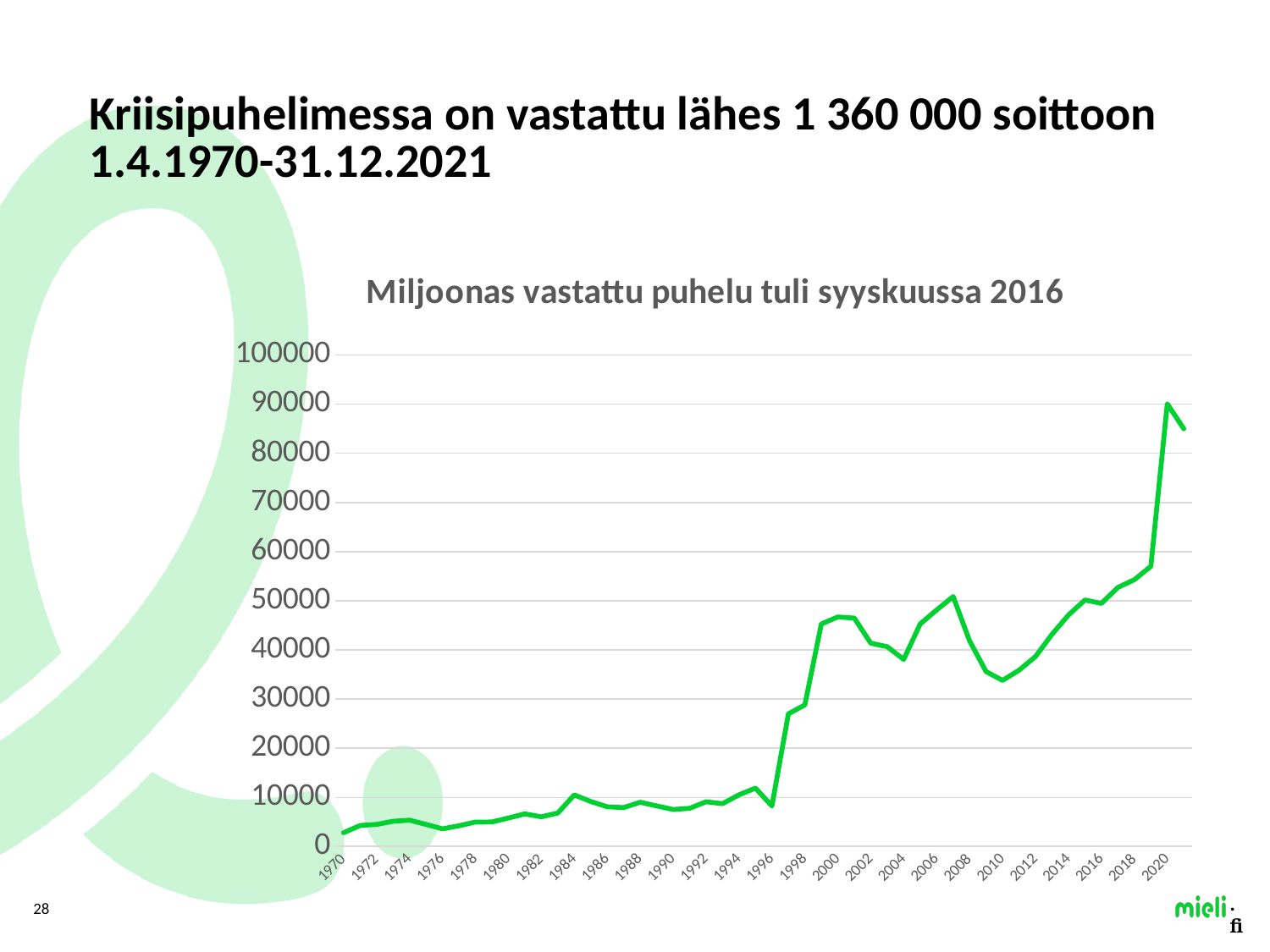
Which year has the lowest value on the chart? 1970 What kind of chart is shown on the slide? line chart Is the value for 1984 greater or less than 20000? less What is the title of the chart? Miljoonas vastattu puhelu tuli syyskuussa 2016 Is the value for 2020 greater or less than 80000? greater Overall, do the values rise or fall from 1970 to 2020? rise Which year has the highest value on the chart? 2020 Is the value for 2000 greater or less than 40000? greater Which is larger, the value for 1998 or the value for 1996? 1998 Which is larger, the value for 2000 or the value for 2010? 2000